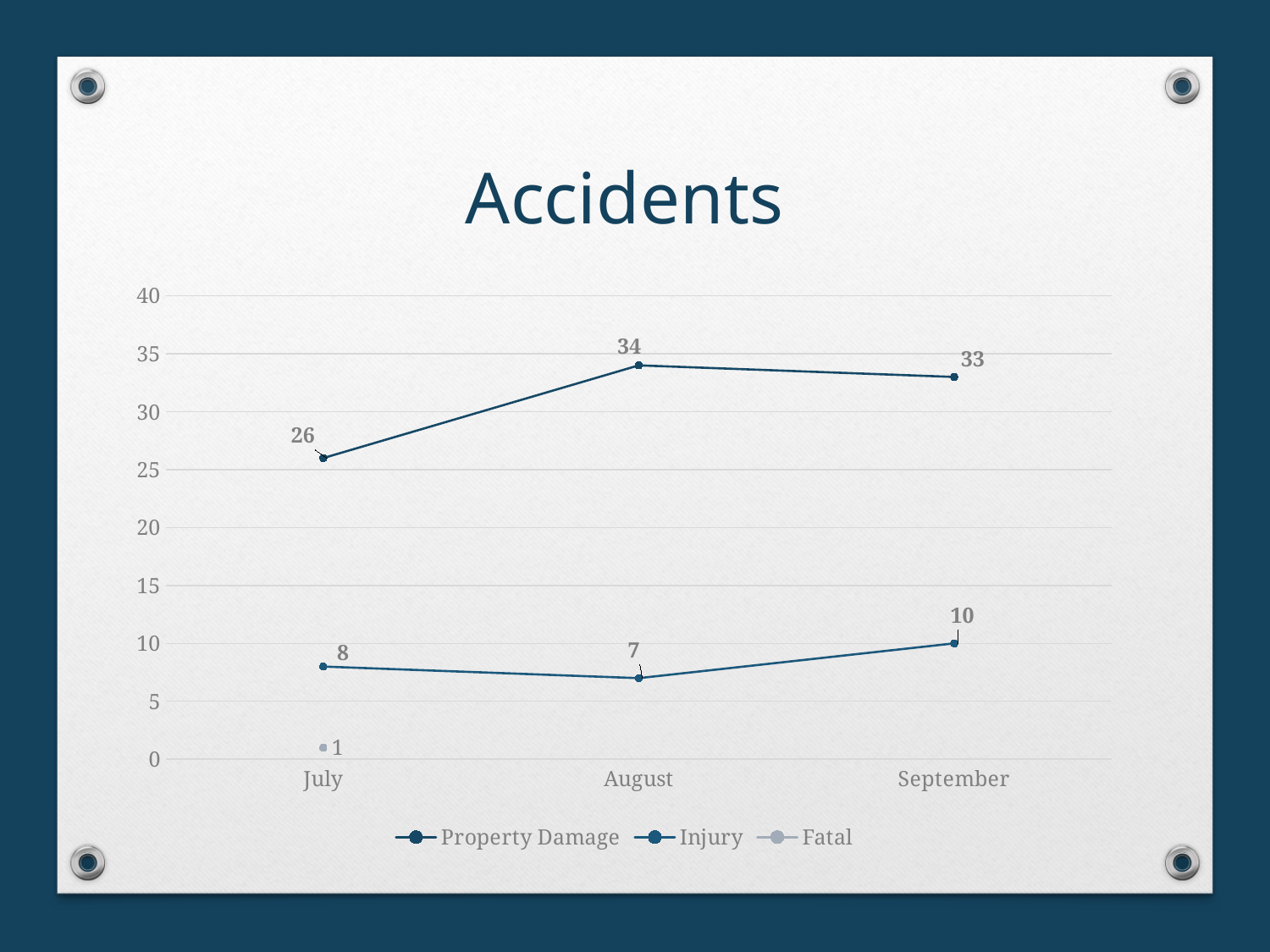
In which month is Injury lowest? August What is the Injury value for September? 10 What is the difference between Property Damage in August and in July? 8 How many series does the legend list? 3 What is the title of the chart? Accidents How many months are shown on the x axis? 3 What is the Property Damage value for August? 34 Which is larger: Injury in July or Injury in August? Injury in July What kind of chart is shown? line chart Is the Property Damage value for September greater or less than 30? greater In which month is Property Damage highest? August What is the Fatal value for July? 1